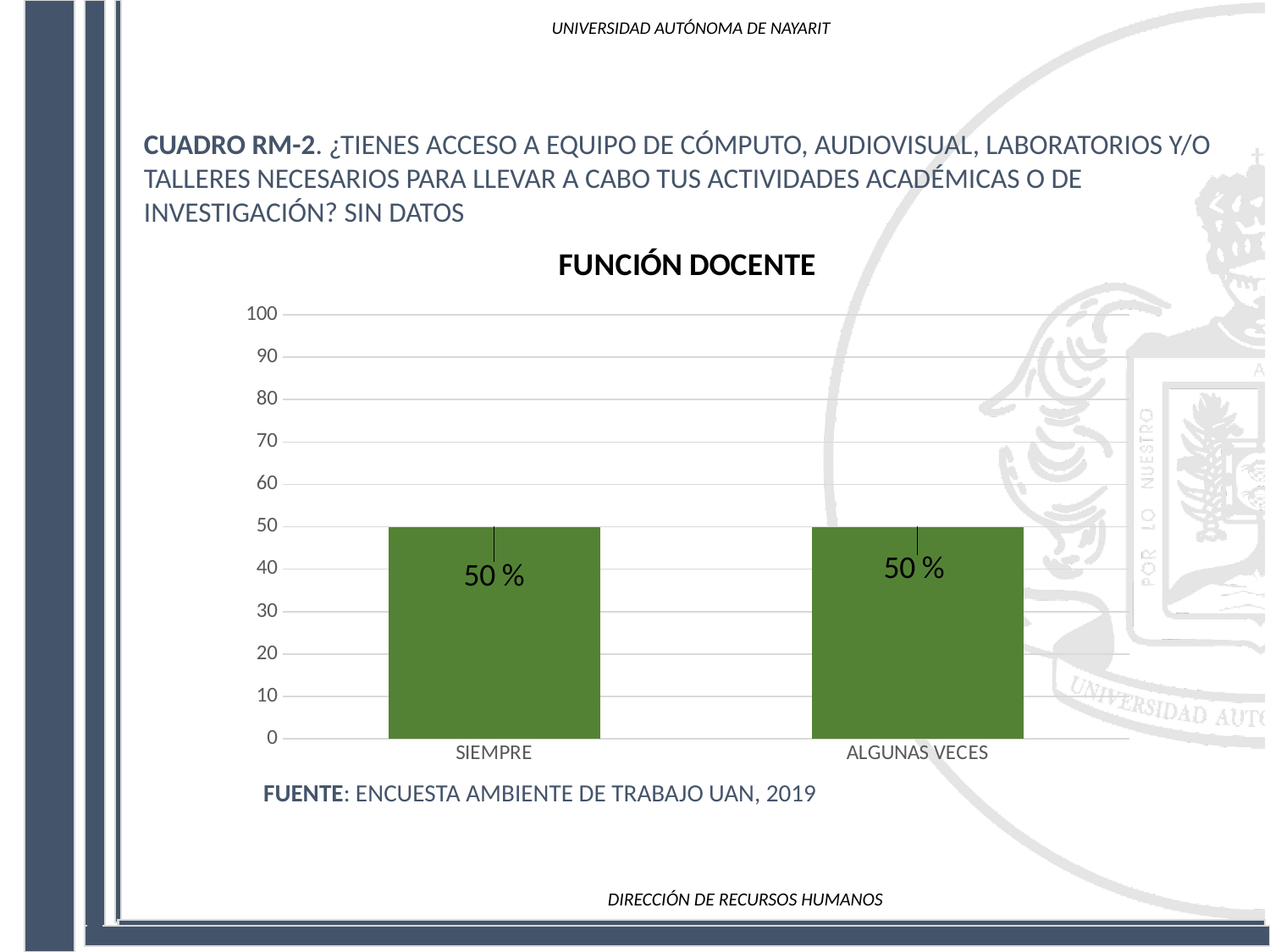
What is the title of the chart? FUNCIÓN DOCENTE What is the difference between the values for SIEMPRE and ALGUNAS VECES? 0 How many categories are shown on the x axis of the chart? 2 What kind of chart is shown on the slide? bar chart What is the value for SIEMPRE? 50 % Do the values rise, fall or stay the same from SIEMPRE to ALGUNAS VECES? stay the same What is the highest value shown on the y axis of the chart? 100 Is the value for ALGUNAS VECES greater or less than 60? less What is the value for ALGUNAS VECES? 50 % Is the value for SIEMPRE greater or less than 40? greater What colour are the bars in the chart? green